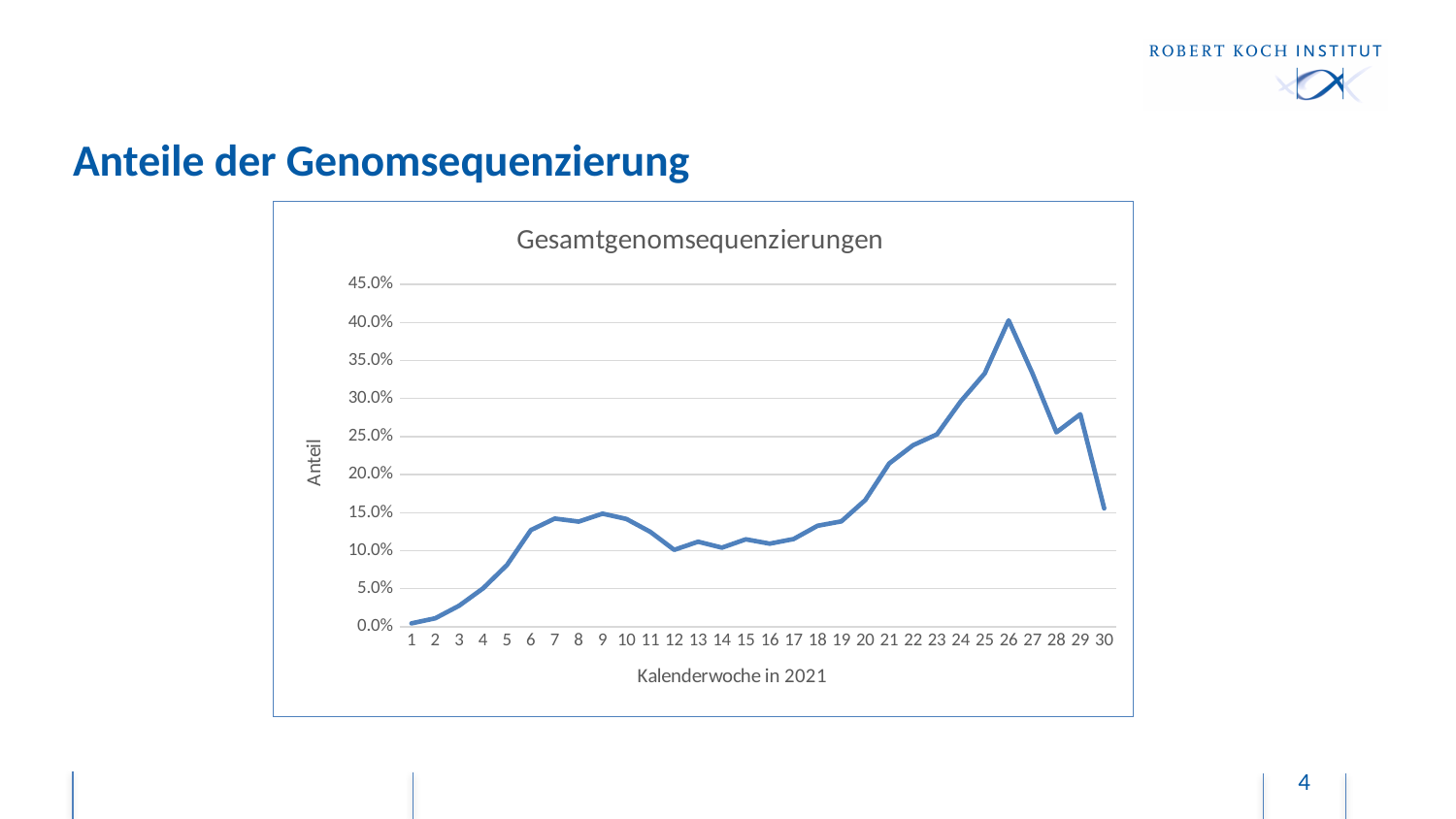
Do the values rise or fall from week 1 to week 6? rise Is the value for week 5 greater or less than 10.0%? less Is the value for week 26 greater or less than 35.0%? greater Which has the larger share, week 26 or week 30? week 26 What kind of chart is shown on the slide? line chart Is the value for week 27 greater or less than 30.0%? greater In which calendar week is the share highest? 26 What is the title of the chart? Gesamtgenomsequenzierungen In which calendar week is the share lowest? 1 How many calendar weeks are plotted on the x axis? 30 What is the label of the x axis? Kalenderwoche in 2021